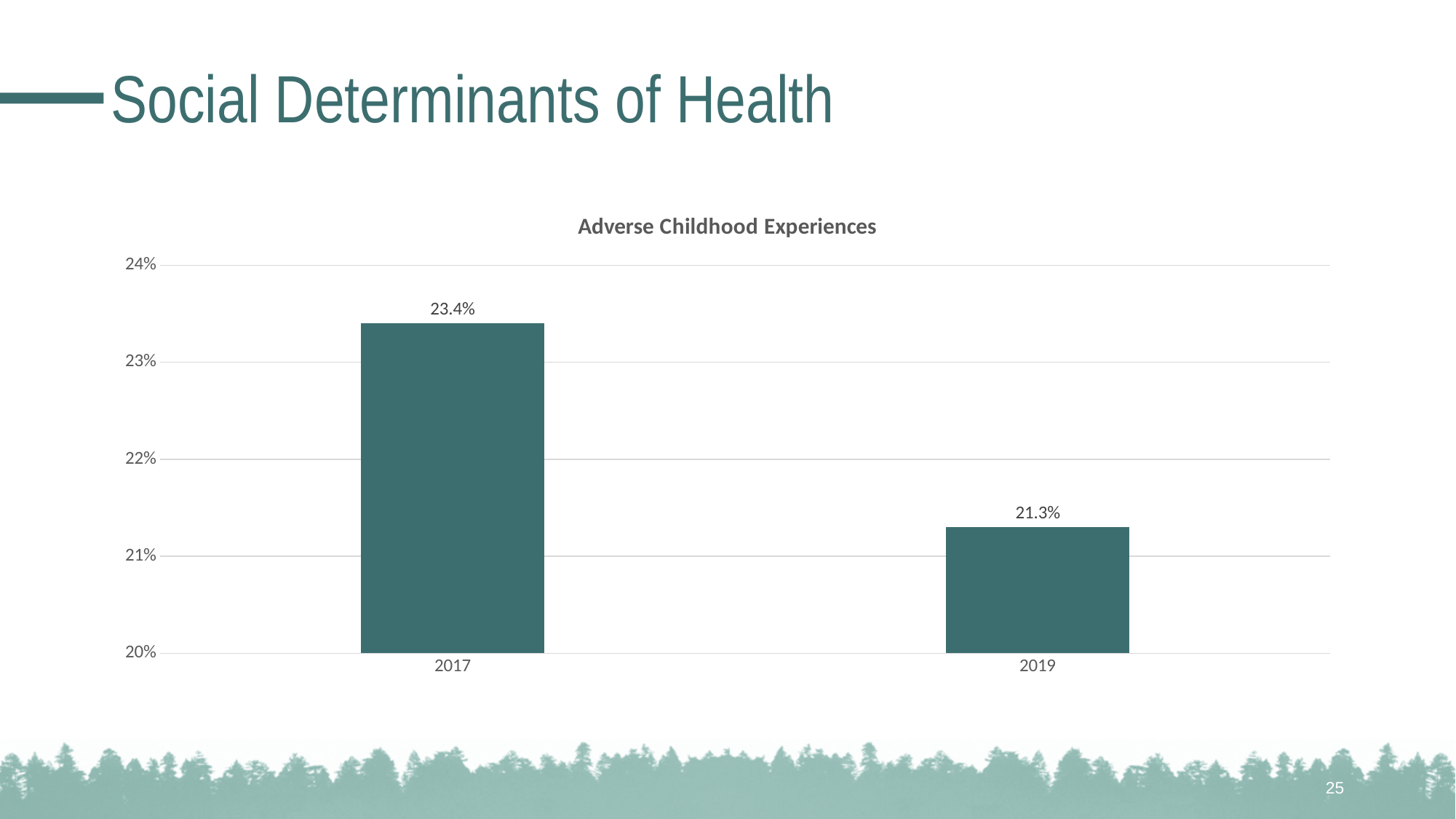
What kind of chart is used to show Adverse Childhood Experiences? Bar chart What is the title of the chart on the slide? Adverse Childhood Experiences Which year has the lowest value in the Adverse Childhood Experiences chart? 2019 What is the value for 2017 in the Adverse Childhood Experiences chart? 23.4% What is the difference between the 2017 and 2019 values in the Adverse Childhood Experiences chart? 2.1% Is the value for 2019 in the Adverse Childhood Experiences chart greater or less than 22%? less Is the value for 2017 in the Adverse Childhood Experiences chart greater or less than 23%? greater What is the value for 2019 in the Adverse Childhood Experiences chart? 21.3% Which year has the highest value in the Adverse Childhood Experiences chart? 2017 Which is larger in the Adverse Childhood Experiences chart, the value for 2017 or the value for 2019? 2017 Do the values in the Adverse Childhood Experiences chart rise or fall from 2017 to 2019? Fall How many years are shown in the Adverse Childhood Experiences chart? 2